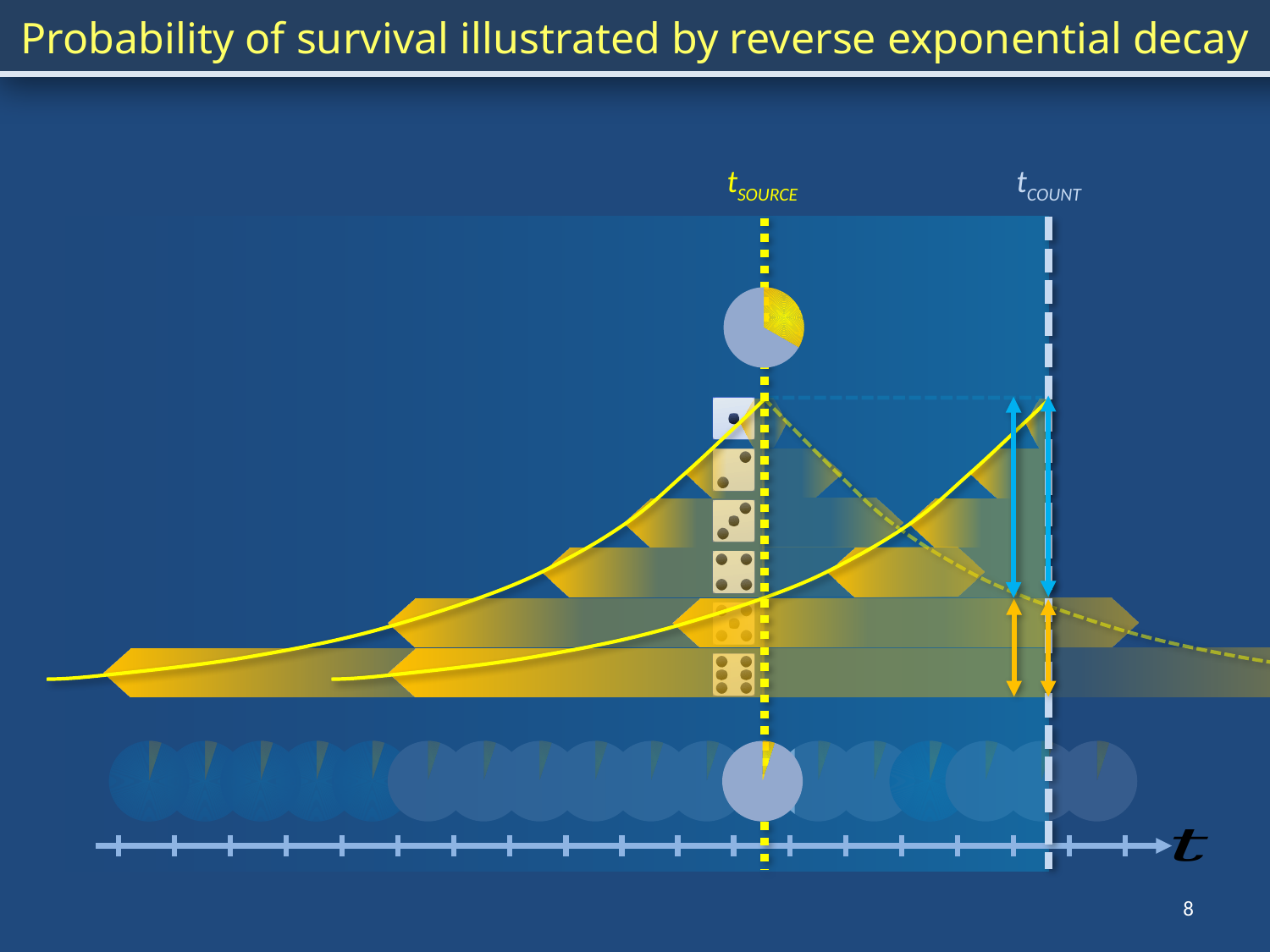
Does the dashed yellow curve to the right of t_SOURCE rise or fall as t increases? fall What label is shown at the right end of the horizontal axis? t Do the solid yellow curves rise or fall as they move to the right along the t axis? rise What is the title of the chart on the slide? Probability of survival illustrated by reverse exponential decay